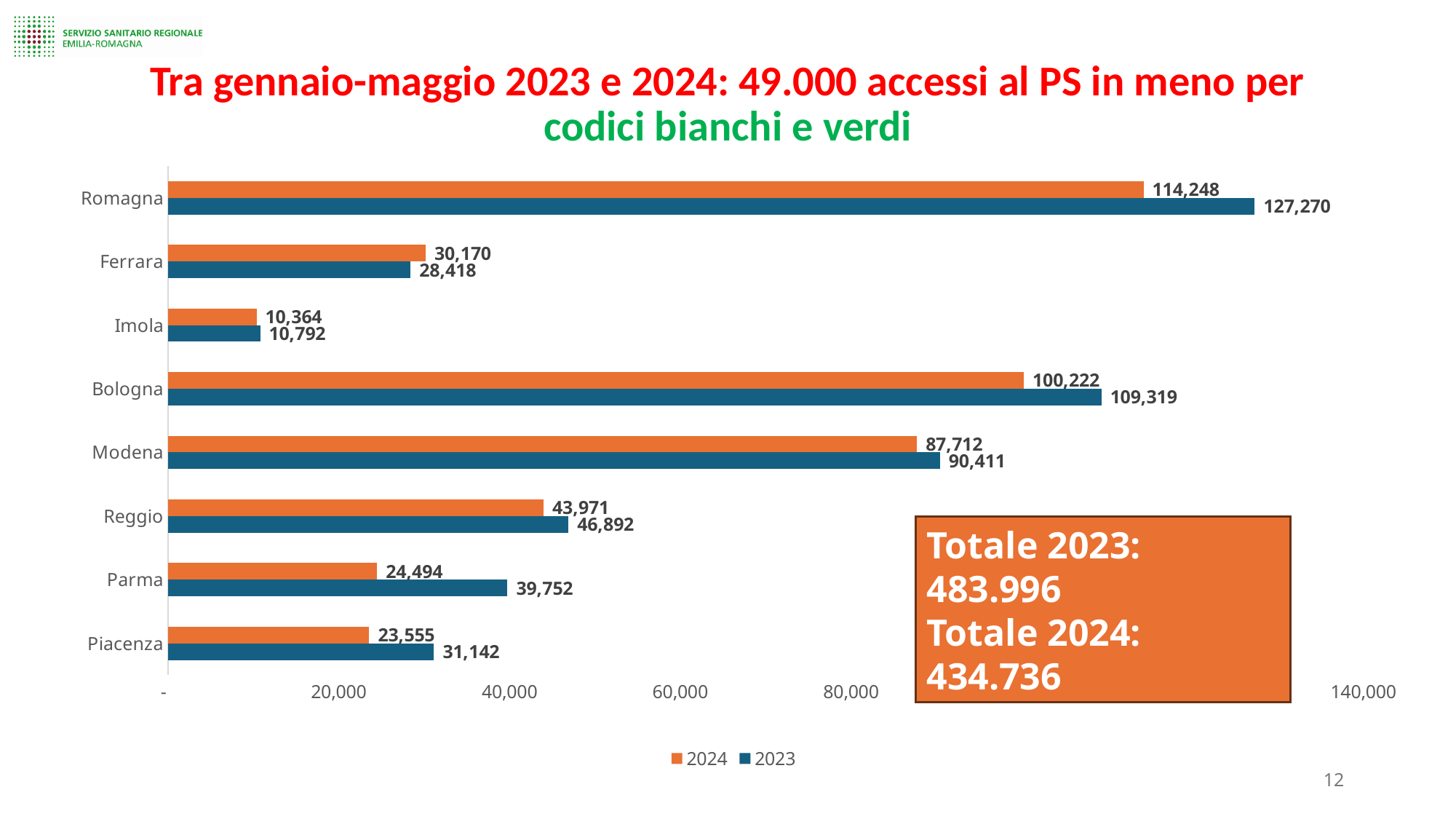
Which colour represents the 2024 series? orange What is the 2023 value for Parma? 39,752 Is the 2023 value for Modena greater or less than 80,000? greater What is the 2024 value for Imola? 10,364 Which category has the highest 2023 value? Romagna How many categories are shown on the chart? 8 What is the difference between the 2023 and 2024 values for Bologna? 9,097 Which is larger for Ferrara, the 2023 value or the 2024 value? 2024 What is the 2024 value for Romagna? 114,248 What kind of chart is shown on the slide? bar chart How many series does the legend list? 2 Which category has the lowest 2024 value? Imola